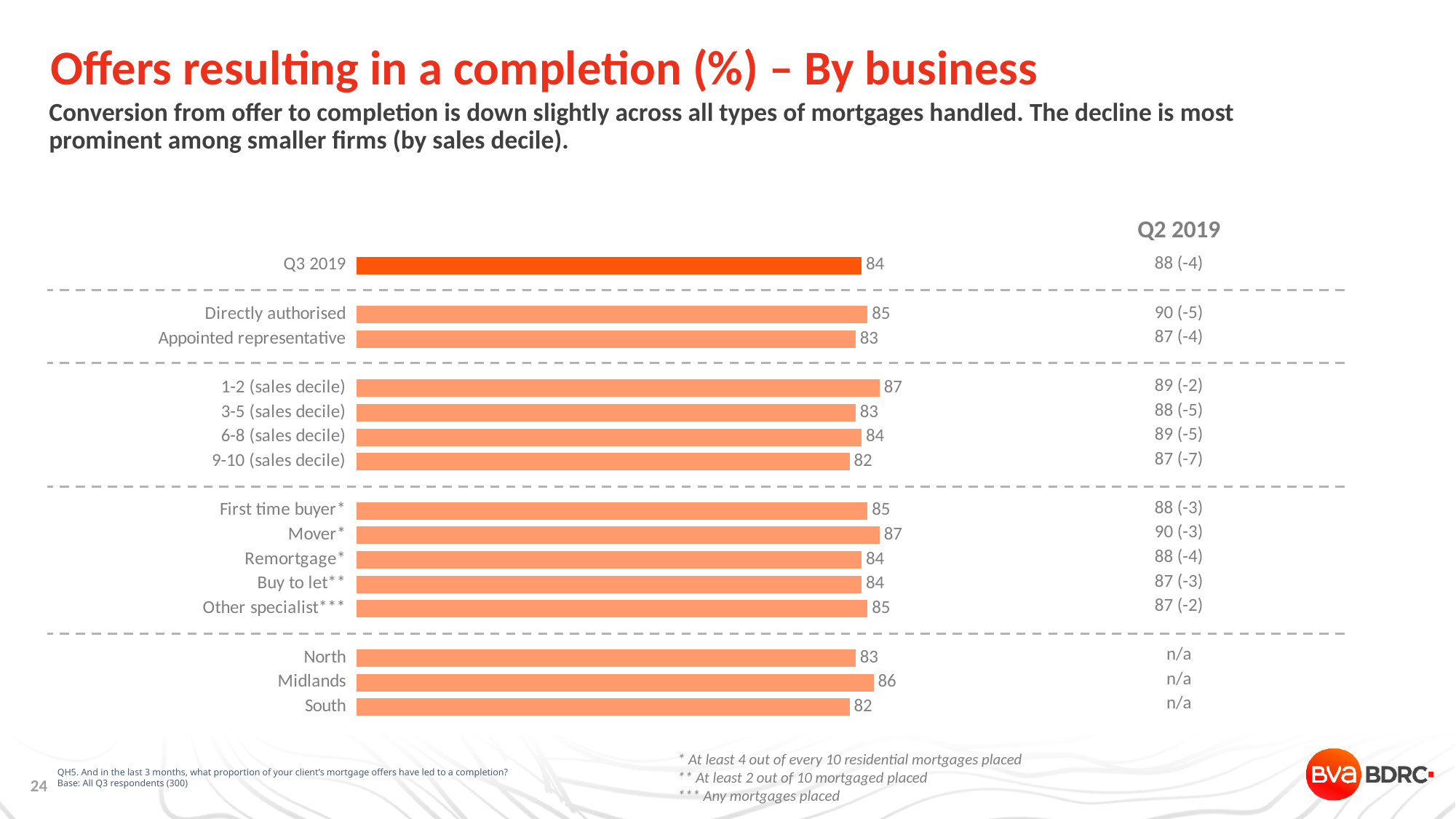
What kind of chart is shown on the slide? Bar chart Among the sales decile categories, which has the highest value? 1-2 (sales decile) What is the value for Midlands? 86 How many bars are plotted in the chart? 15 Among the regions (North, Midlands, South), which has the lowest value? South Among the sales decile categories, which has the lowest value? 9-10 (sales decile) What is the value for Mover? 87 What is the difference between the values for Directly authorised and Appointed representative? 2 What is the difference between the values for 1-2 (sales decile) and 9-10 (sales decile)? 5 What is the value for Q3 2019 overall? 84 Which is larger, the value for Midlands or the value for North? Midlands What is the value for Appointed representative? 83